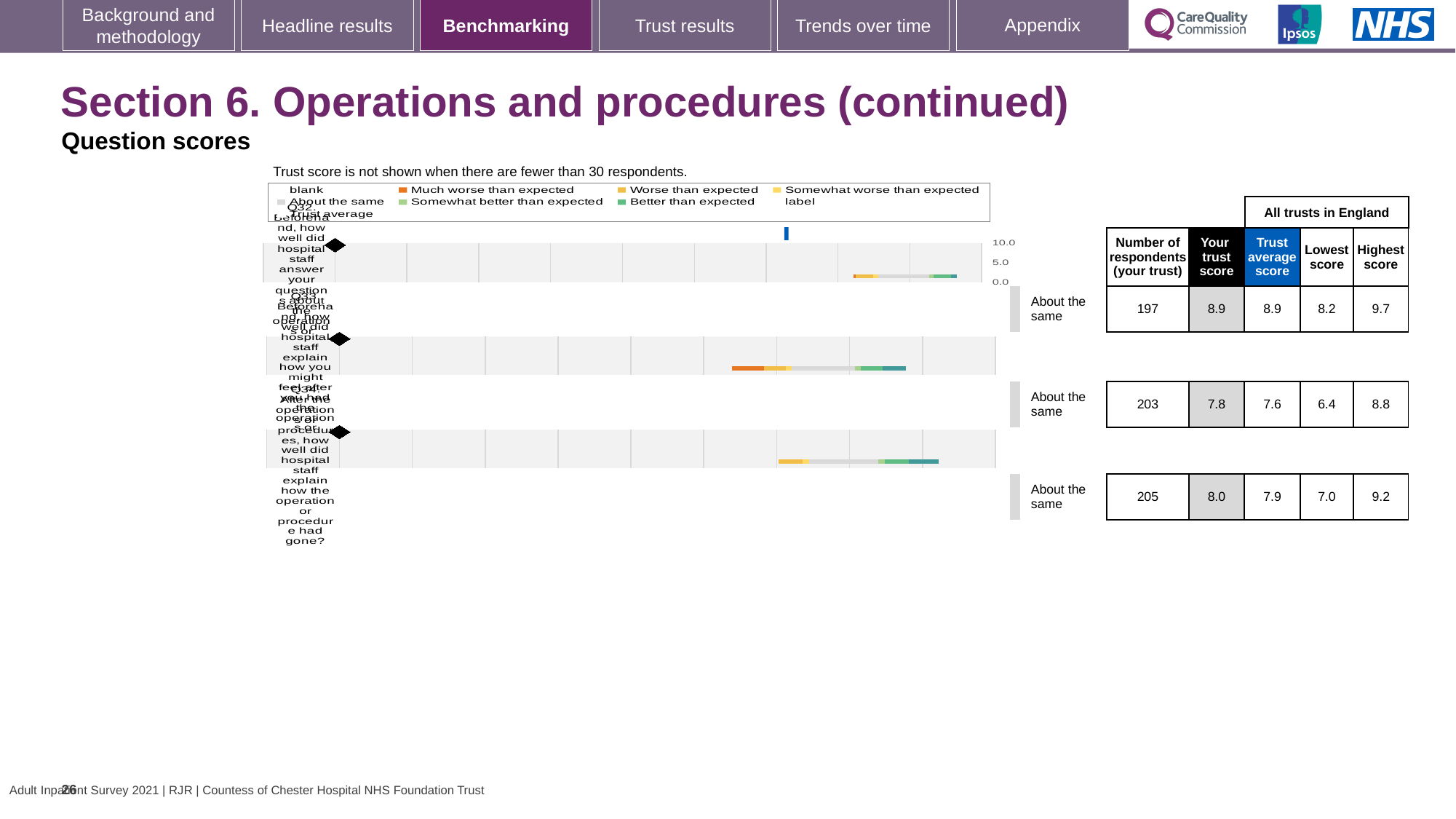
What is the trust score for the second question row? 7.8 Which question row has the fewest respondents? the first (top) row, 197 Is the trust score for the second row larger or smaller than its trust average score? larger What benchmark category is shown for each of the three question rows? About the same How many question rows are plotted in the chart? 3 What kind of chart is shown on the slide? bar chart What is the highest score across all trusts in England for the third question row? 9.2 What is the number of respondents for the first (top) question row? 197 What is the lowest score across all trusts in England for the second question row? 6.4 What is the difference in number of respondents between the third row and the first row? 8 Which question row has the highest trust score? the first (top) row, 8.9 What note is printed above the chart about when the trust score is not shown? Trust score is not shown when there are fewer than 30 respondents.